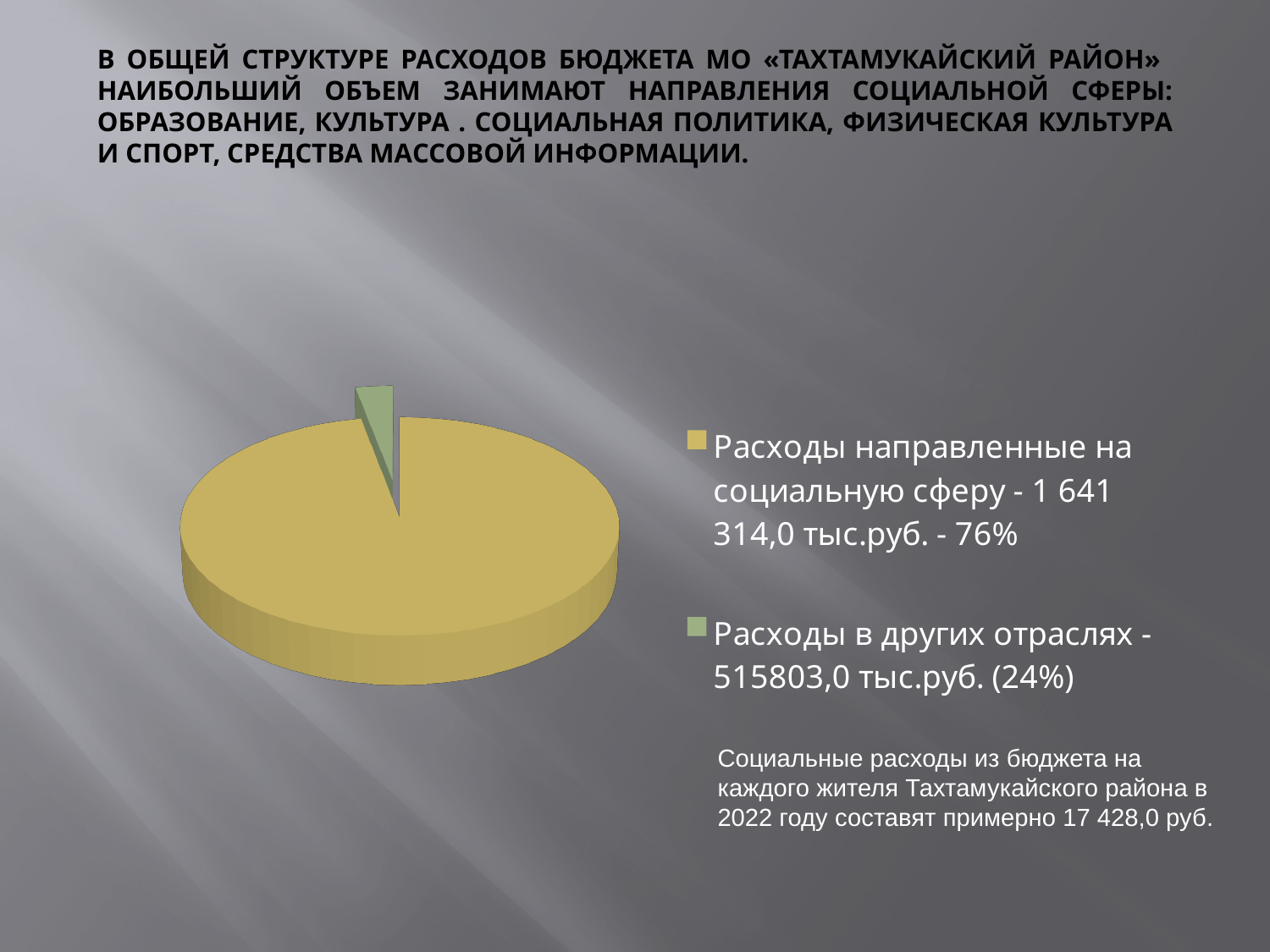
What amount is given in the legend for 'Расходы в других отраслях'? 515803,0 тыс.руб. Which is larger: 'Расходы направленные на социальную сферу' or 'Расходы в других отраслях'? Расходы направленные на социальную сферу What share of the pie does 'Расходы в других отраслях' represent according to the legend? 24% What share of the pie does 'Расходы направленные на социальную сферу' represent according to the legend? 76% What kind of chart is shown on the slide? pie chart What colour is the slice for 'Расходы в других отраслях'? green How many slices does the pie chart have? 2 What amount is given in the legend for 'Расходы направленные на социальную сферу'? 1 641 314,0 тыс.руб. Which category has the largest slice of the pie? Расходы направленные на социальную сферу How many entries does the legend of the pie chart list? 2 Which category has the smallest slice of the pie? Расходы в других отраслях By how much does 'Расходы направленные на социальную сферу' exceed 'Расходы в других отраслях' according to the legend amounts? 1 125 511,0 тыс.руб.